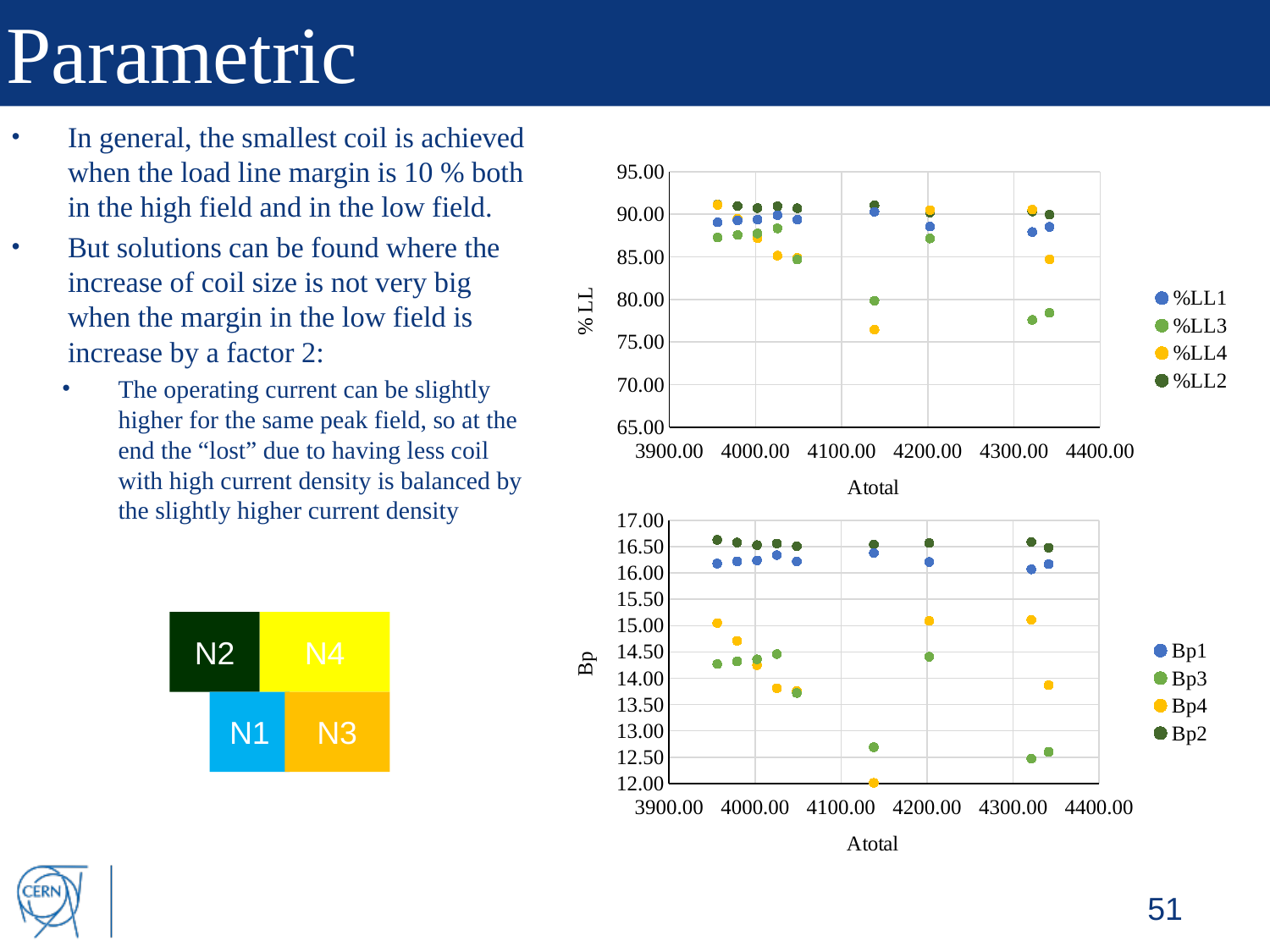
In the bottom chart (Bp vs Atotal), at Atotal of about 4140, which is larger, Bp2 or Bp3? Bp2 What kind of chart is the top chart (% LL vs Atotal)? scatter chart In the top chart (% LL vs Atotal), are the %LL2 values greater or less than 85.00? greater What is the x-axis label of the bottom chart (Bp vs Atotal)? Atotal In the bottom chart (Bp vs Atotal), is the Bp4 value at Atotal of about 3980 greater or less than 14.50? greater In the top chart (% LL vs Atotal), at Atotal of about 4320, which is larger, %LL2 or %LL3? %LL2 How many series does the legend of the top chart (% LL vs Atotal) list? 4 In the top chart (% LL vs Atotal), do the %LL3 values overall rise or fall as Atotal increases from 3900 to 4400? fall Which series are listed in the legend of the bottom chart (Bp vs Atotal)? Bp1, Bp3, Bp4, Bp2 In the bottom chart (Bp vs Atotal), is the Bp3 value at Atotal of about 4140 greater or less than 13.00? less How many series does the legend of the bottom chart (Bp vs Atotal) list? 4